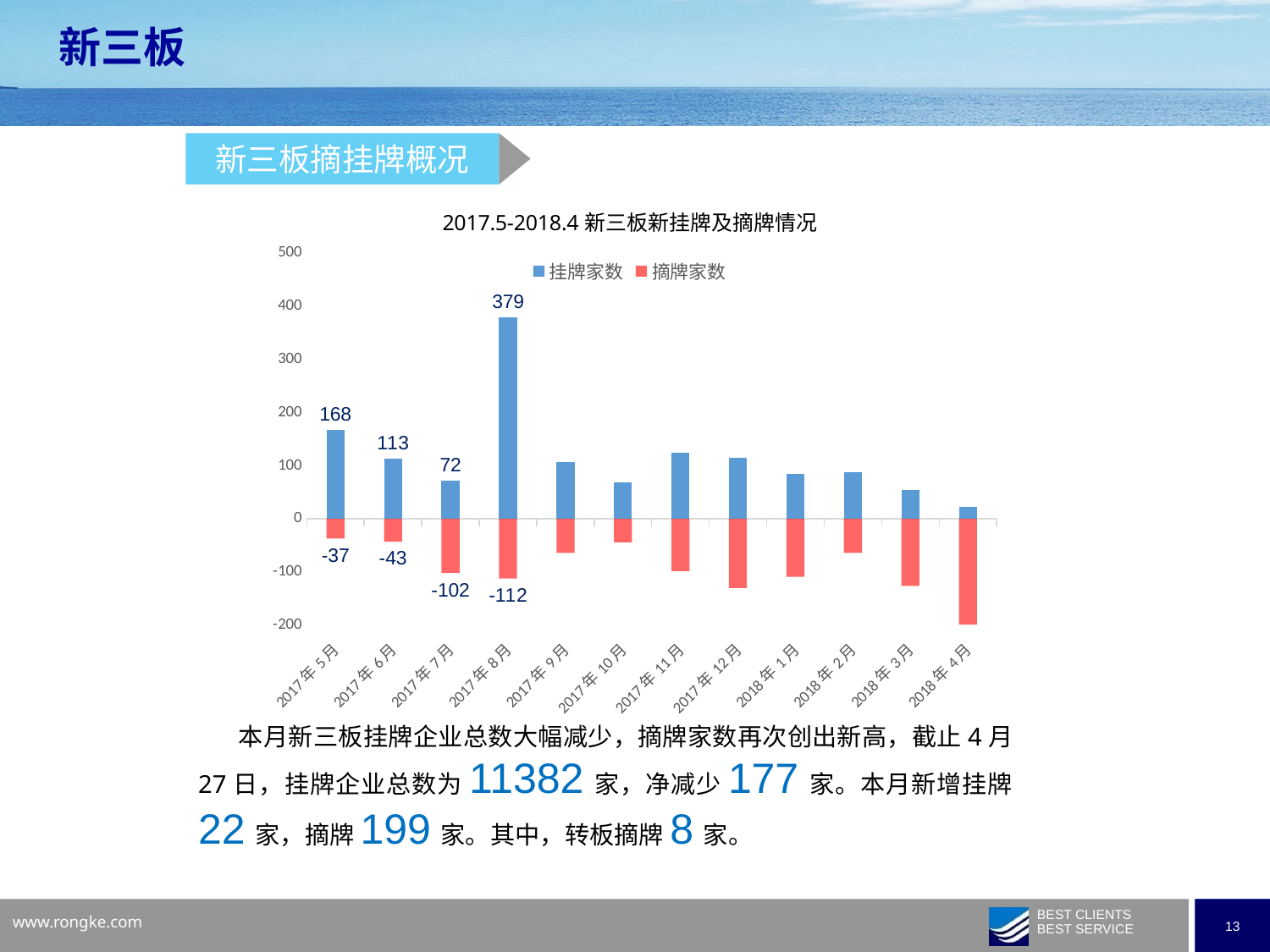
Is the 摘牌家数 value for 2018年4月 greater or less than -100? less What type of chart is shown on the slide? bar chart What is the 摘牌家数 value for 2017年6月? -43 What is the 挂牌家数 value for 2017年8月? 379 What is the 摘牌家数 value for 2017年7月? -102 What is the difference between the 挂牌家数 for 2017年5月 and 2017年6月? 55 Is the 挂牌家数 value for 2017年9月 greater or less than 200? less How many series does the chart legend list? 2 Which month has the highest 挂牌家数? 2017年8月 Which month has the lowest (most negative) 摘牌家数? 2018年4月 How many months are shown on the x axis of the chart? 12 Which month has the larger 挂牌家数, 2017年5月 or 2017年7月? 2017年5月